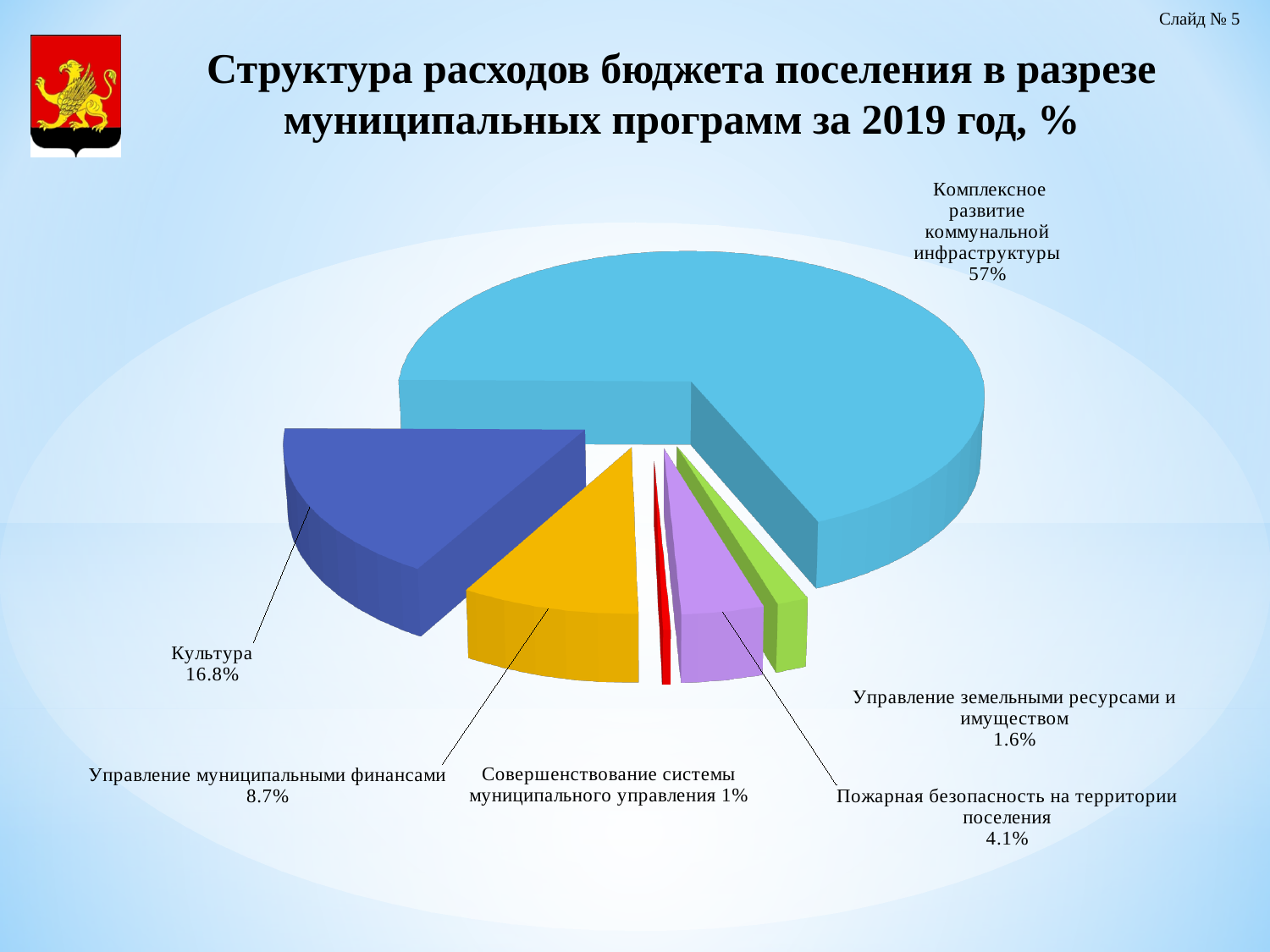
What is the value shown for Пожарная безопасность на территории поселения? 4.1% What is the value shown for Культура? 16.8% What kind of chart is shown on the slide? Pie chart How many programs (slices) are shown in the pie chart? 6 What is the value shown for Управление земельными ресурсами и имуществом? 1.6% By how many percentage points does Культура exceed Управление муниципальными финансами? 8.1 What share of the budget expenditure goes to Комплексное развитие коммунальной инфраструктуры? 57% Which is larger: the share for Пожарная безопасность на территории поселения or for Управление земельными ресурсами и имуществом? Пожарная безопасность на территории поселения Which program has the largest share of the budget expenditure? Комплексное развитие коммунальной инфраструктуры What is the value shown for Управление муниципальными финансами? 8.7% What is the value shown for Совершенствование системы муниципального управления? 1% Which program has the smallest share of the budget expenditure? Совершенствование системы муниципального управления